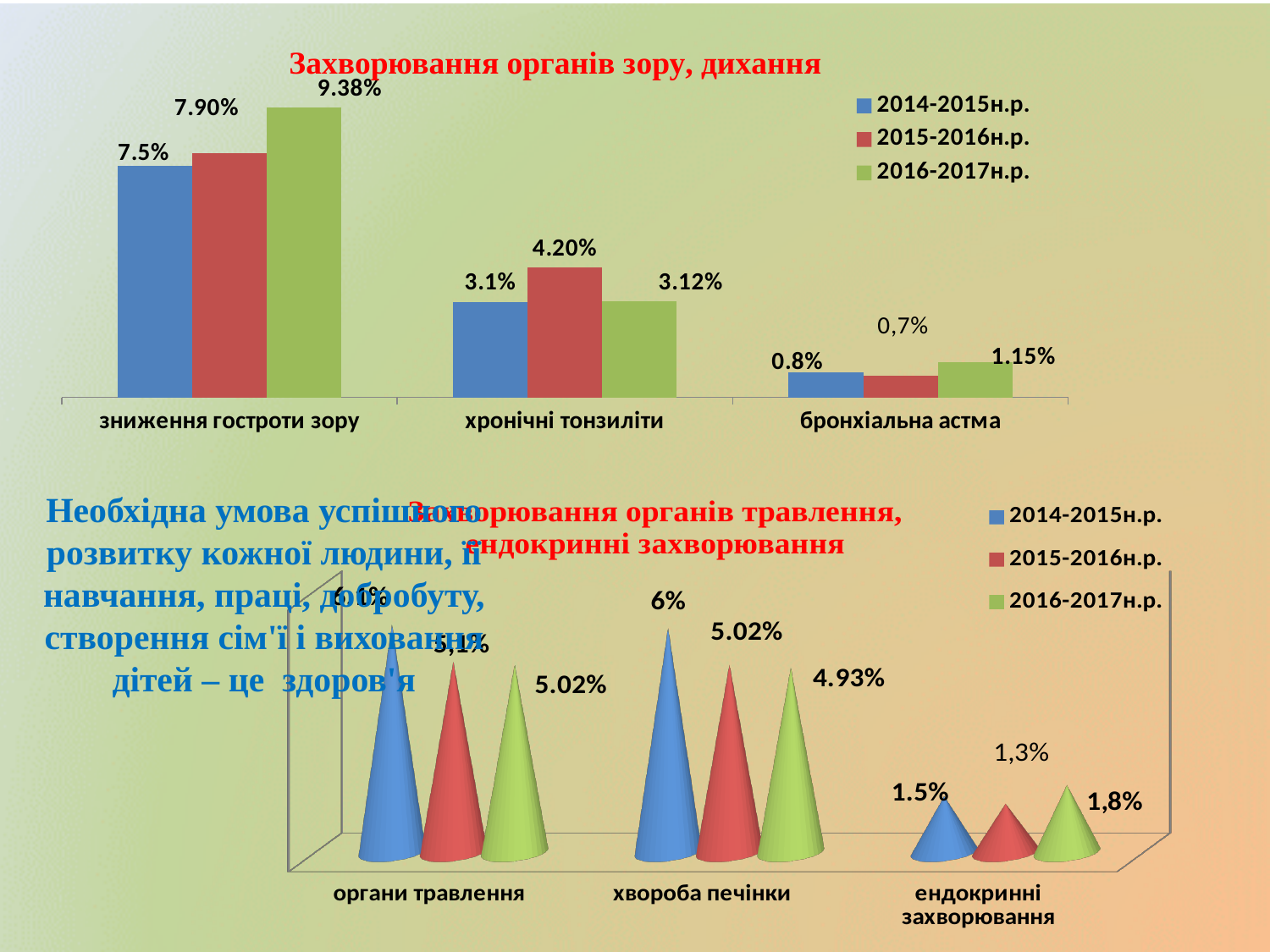
In the bottom chart 'Захворювання органів травлення, ендокринні захворювання', how many categories are shown on the x axis? 3 In the top chart 'Захворювання органів зору, дихання', what is the value for хронічні тонзиліти in 2015-2016н.р.? 4.20% In the top chart 'Захворювання органів зору, дихання', what is the difference between the 2016-2017н.р. and 2014-2015н.р. values for зниження гостроти зору? 1.88% In the bottom chart 'Захворювання органів травлення, ендокринні захворювання', what is the value for хвороба печінки in 2014-2015н.р.? 6% In the top chart 'Захворювання органів зору, дихання', what is the value for бронхіальна астма in 2014-2015н.р.? 0.8% In the top chart 'Захворювання органів зору, дихання', how many series does the legend list? 3 In the top chart 'Захворювання органів зору, дихання', what is the value for зниження гостроти зору in 2016-2017н.р.? 9.38% In the top chart 'Захворювання органів зору, дихання', which category has the lowest value in 2015-2016н.р.? бронхіальна астма What kind of chart is the top chart 'Захворювання органів зору, дихання'? bar chart In the top chart 'Захворювання органів зору, дихання', which category has the highest value in 2016-2017н.р.? зниження гостроти зору In the bottom chart 'Захворювання органів травлення, ендокринні захворювання', what is the value for ендокринні захворювання in 2016-2017н.р.? 1,8% In the bottom chart 'Захворювання органів травлення, ендокринні захворювання', which is larger for хвороба печінки: the 2015-2016н.р. value or the 2016-2017н.р. value? 2015-2016н.р.